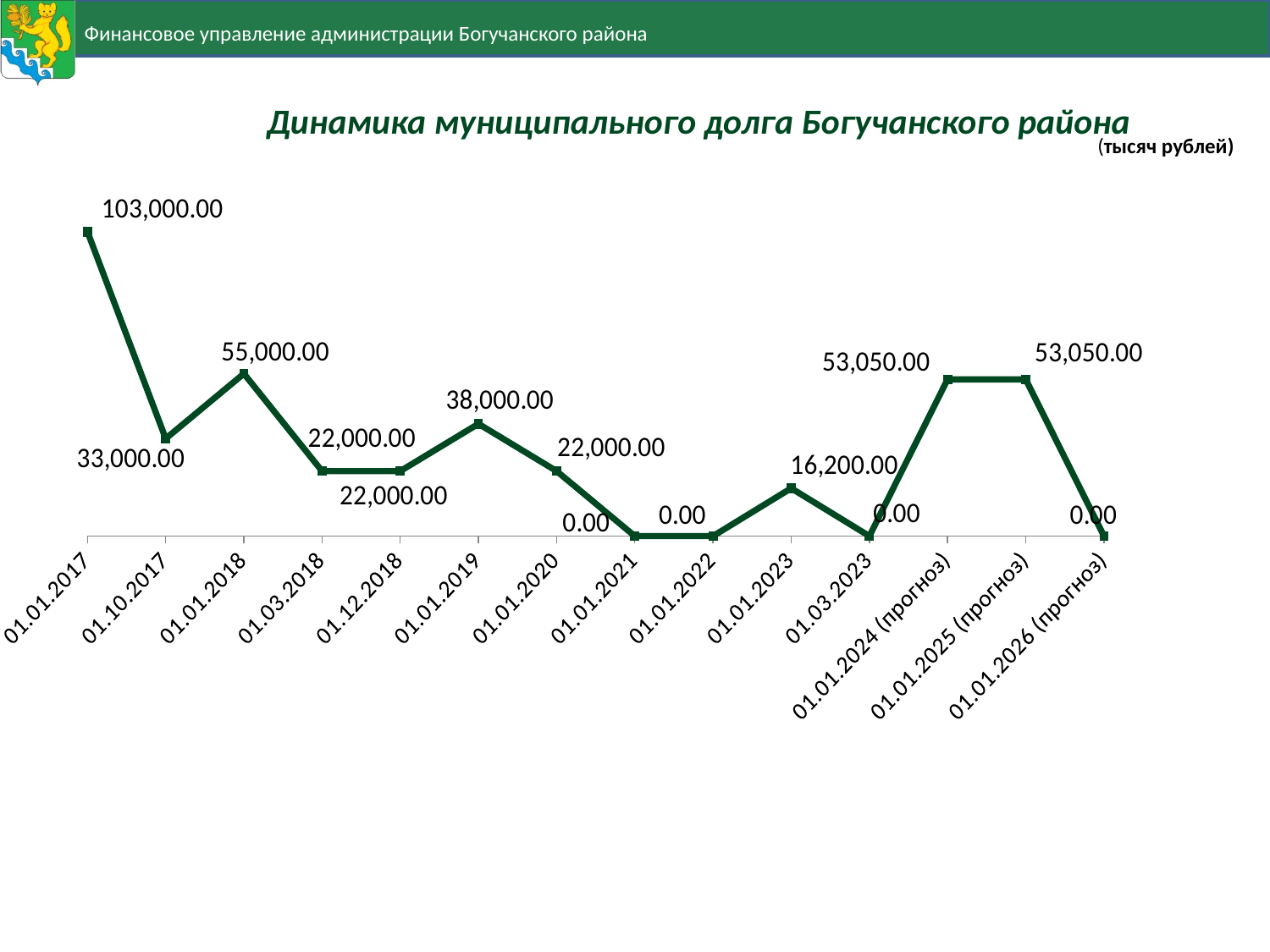
What is the difference between the values for 01.01.2018 and 01.03.2018? 33,000.00 Which date has the highest value? 01.01.2017 What is the title of the chart? Динамика муниципального долга Богучанского района What is the value for 01.01.2023? 16,200.00 Which is larger, the value for 01.01.2018 or the value for 01.01.2019? 01.01.2018 What is the value for 01.01.2019? 38,000.00 What is the difference between the values for 01.01.2017 and 01.10.2017? 70,000.00 Does the value rise or fall from 01.01.2025 (прогноз) to 01.01.2026 (прогноз)? Fall What kind of chart is shown on the slide? Line chart How many data points are plotted on the chart? 14 What is the value for 01.01.2017? 103,000.00 What is the value for 01.01.2024 (прогноз)? 53,050.00